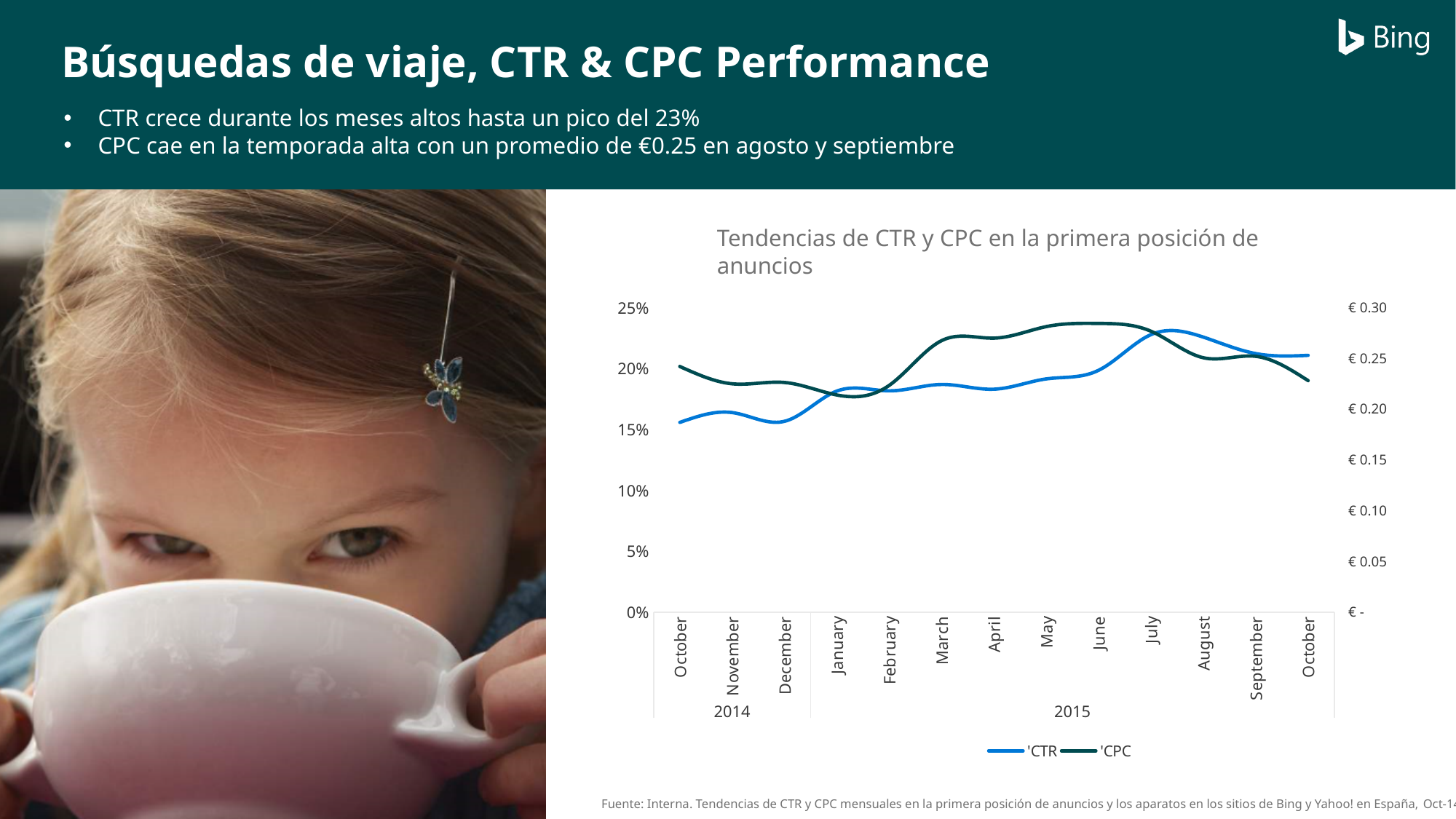
Which two series are listed in the chart legend? CTR and CPC Is the CTR value for July 2015 greater or less than 20%? greater Is the CPC value for June 2015 greater or less than € 0.25? greater What kind of chart is shown on the slide? Line chart Is the CTR value higher in July 2015 or in October 2014? July 2015 Which month has the lowest CPC value on the chart? January 2015 How many months are plotted along the x axis of the chart? 13 Is the CPC value for January 2015 greater or less than € 0.25? less Does the CPC line rise or fall from June 2015 to October 2015? Fall What is the title of the chart? Tendencias de CTR y CPC en la primera posición de anuncios How many series does the chart legend list? 2